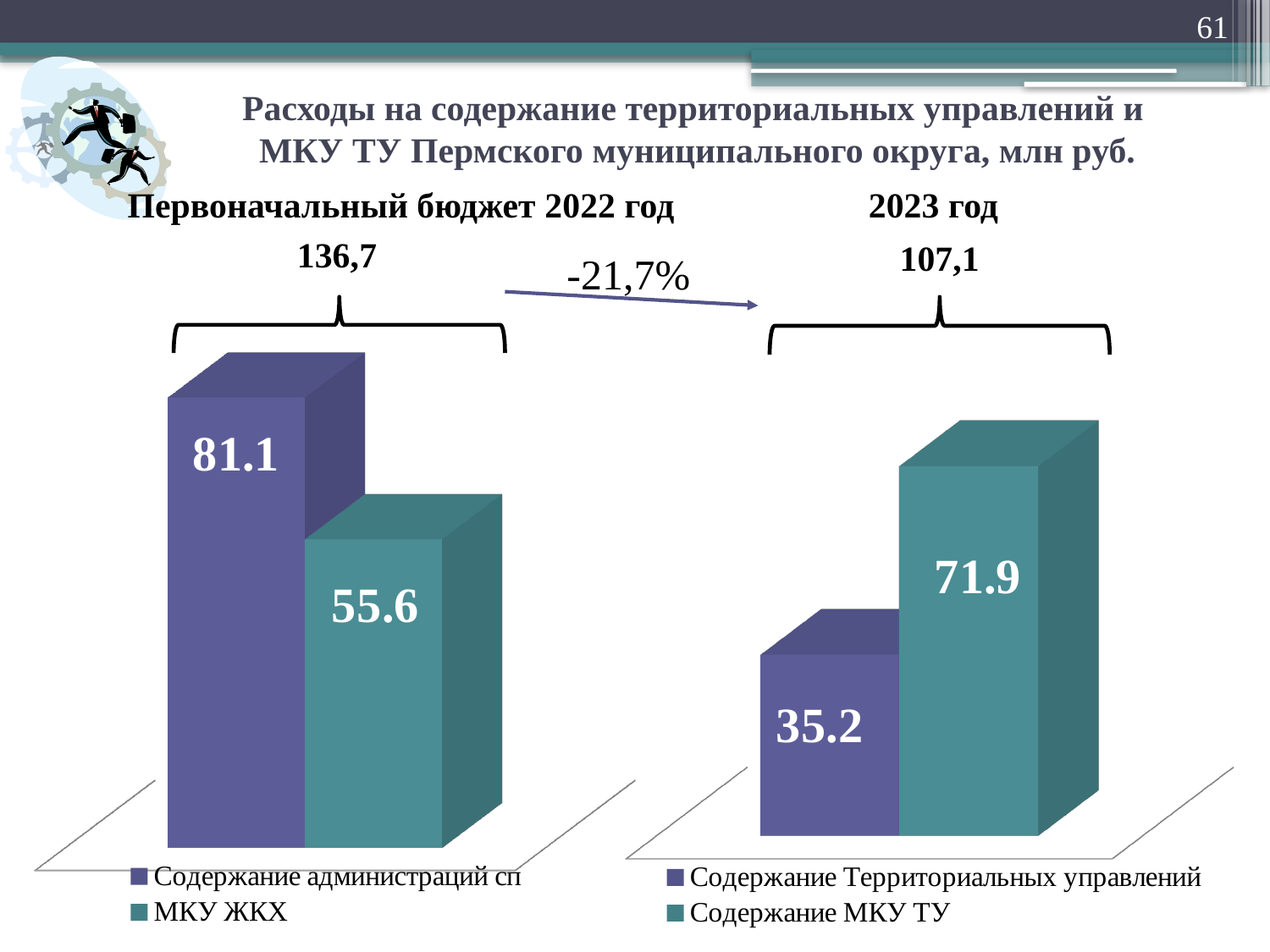
In the right chart (2023 год), what is the difference between Содержание МКУ ТУ and Содержание Территориальных управлений? 36.7 Is the value for Содержание МКУ ТУ in the right chart (2023 год) larger or smaller than the value for МКУ ЖКХ in the left chart (Первоначальный бюджет 2022 год)? larger What is the total shown above the left chart (Первоначальный бюджет 2022 год)? 136,7 What is the total shown above the right chart (2023 год)? 107,1 In the right chart (2023 год), what is the value for Содержание Территориальных управлений? 35.2 In the right chart (2023 год), which series has the lower value? Содержание Территориальных управлений In the left chart (Первоначальный бюджет 2022 год), what is the difference between Содержание администраций сп and МКУ ЖКХ? 25.5 In the right chart (2023 год), what is the value for Содержание МКУ ТУ? 71.9 In the left chart (Первоначальный бюджет 2022 год), which series has the higher value? Содержание администраций сп In the left chart (Первоначальный бюджет 2022 год), what is the value for МКУ ЖКХ? 55.6 What kind of chart is used on this slide? bar chart In the left chart (Первоначальный бюджет 2022 год), what is the value for Содержание администраций сп? 81.1